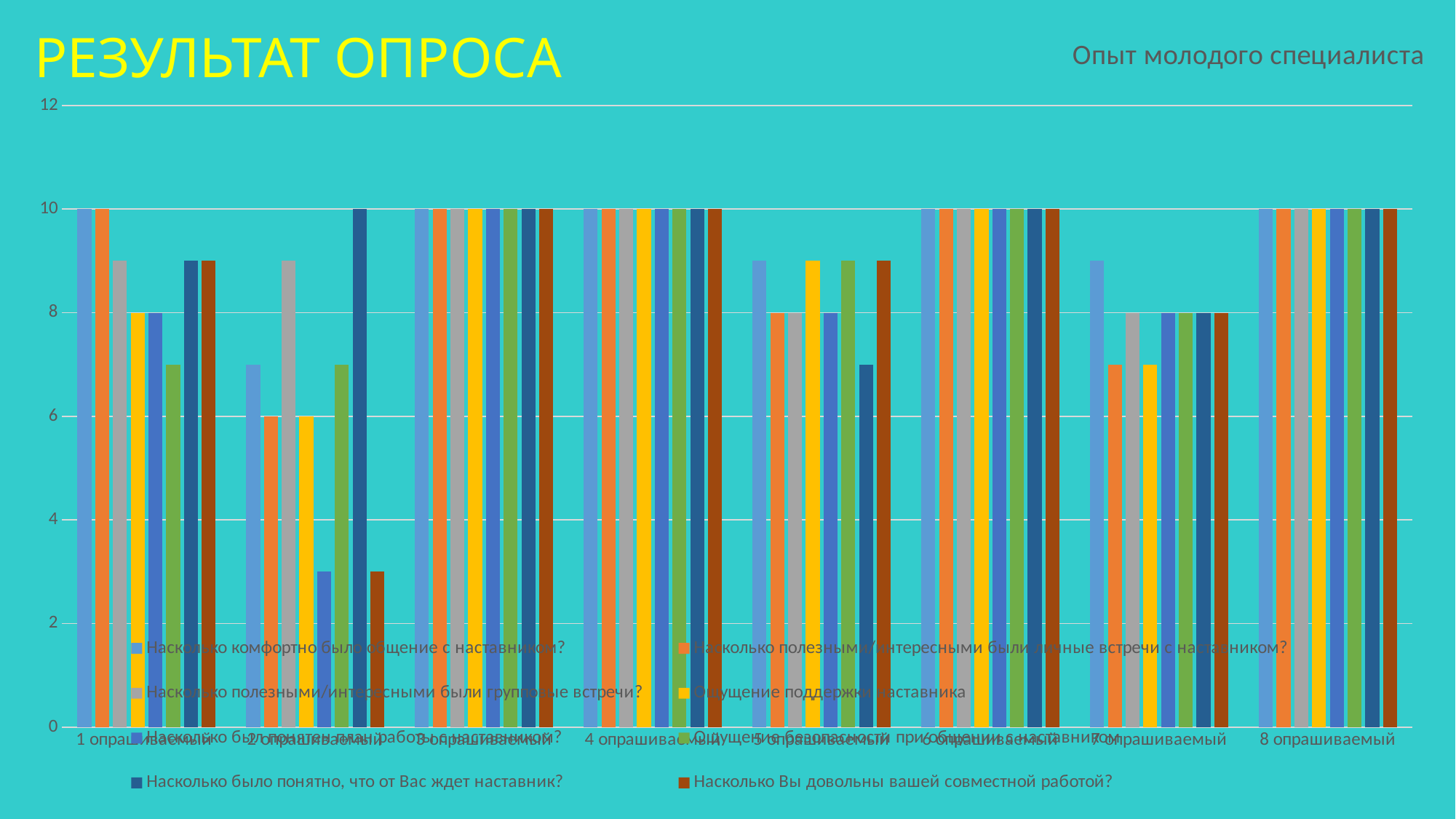
Is the value for "Насколько Вы довольны вашей совместной работой?" for 2 опрашиваемый greater or less than 4? less For the series "Насколько Вы довольны вашей совместной работой?", which respondent has the lowest value? 2 опрашиваемый For 1 опрашиваемый, what is the difference between "Насколько комфортно было общение с наставником?" and "Ощущение поддержки наставника"? 2 What is the value for "Насколько полезными/интересными были личные встречи с наставником?" for 2 опрашиваемый? 6 What is the value for "Насколько комфортно было общение с наставником?" for 1 опрашиваемый? 10 What is the value for "Насколько полезными/интересными были групповые встречи?" for 7 опрашиваемый? 8 What kind of chart is shown on the slide? Bar chart What is the value for "Ощущение поддержки наставника" for 1 опрашиваемый? 8 How many respondent categories (опрашиваемый) are shown along the x axis? 8 How many series does the legend list? 8 For 1 опрашиваемый, which is larger: "Насколько комфортно было общение с наставником?" or "Ощущение поддержки наставника"? Насколько комфортно было общение с наставником? Is the value for "Насколько было понятно, что от Вас ждет наставник?" for 5 опрашиваемый greater or less than 8? less